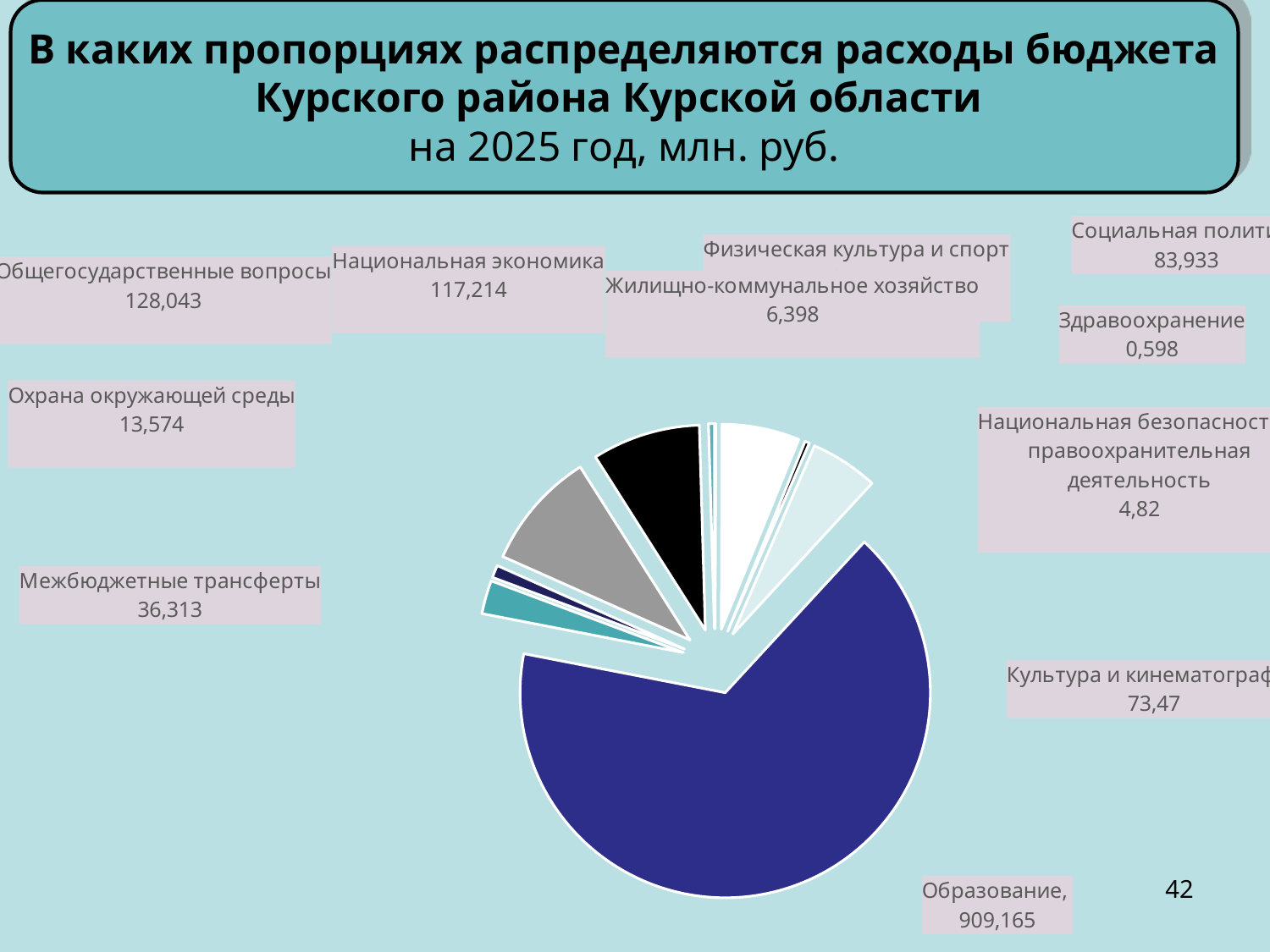
What is the difference between Общегосударственные вопросы and Национальная экономика? 10,829 What is the value for Национальная экономика? 117,214 What is the value for Общегосударственные вопросы? 128,043 What kind of chart is shown on the slide? Pie chart What is the value for Образование? 909,165 What is the value for Межбюджетные трансферты? 36,313 Which category has the highest value? Образование What colour is the Образование slice? Dark blue What is the difference between Межбюджетные трансферты and Охрана окружающей среды? 22,739 What is the value for Национальная безопасность и правоохранительная деятельность? 4,82 What is the value for Здравоохранение? 0,598 Which is larger, Жилищно-коммунальное хозяйство or Национальная безопасность и правоохранительная деятельность? Жилищно-коммунальное хозяйство